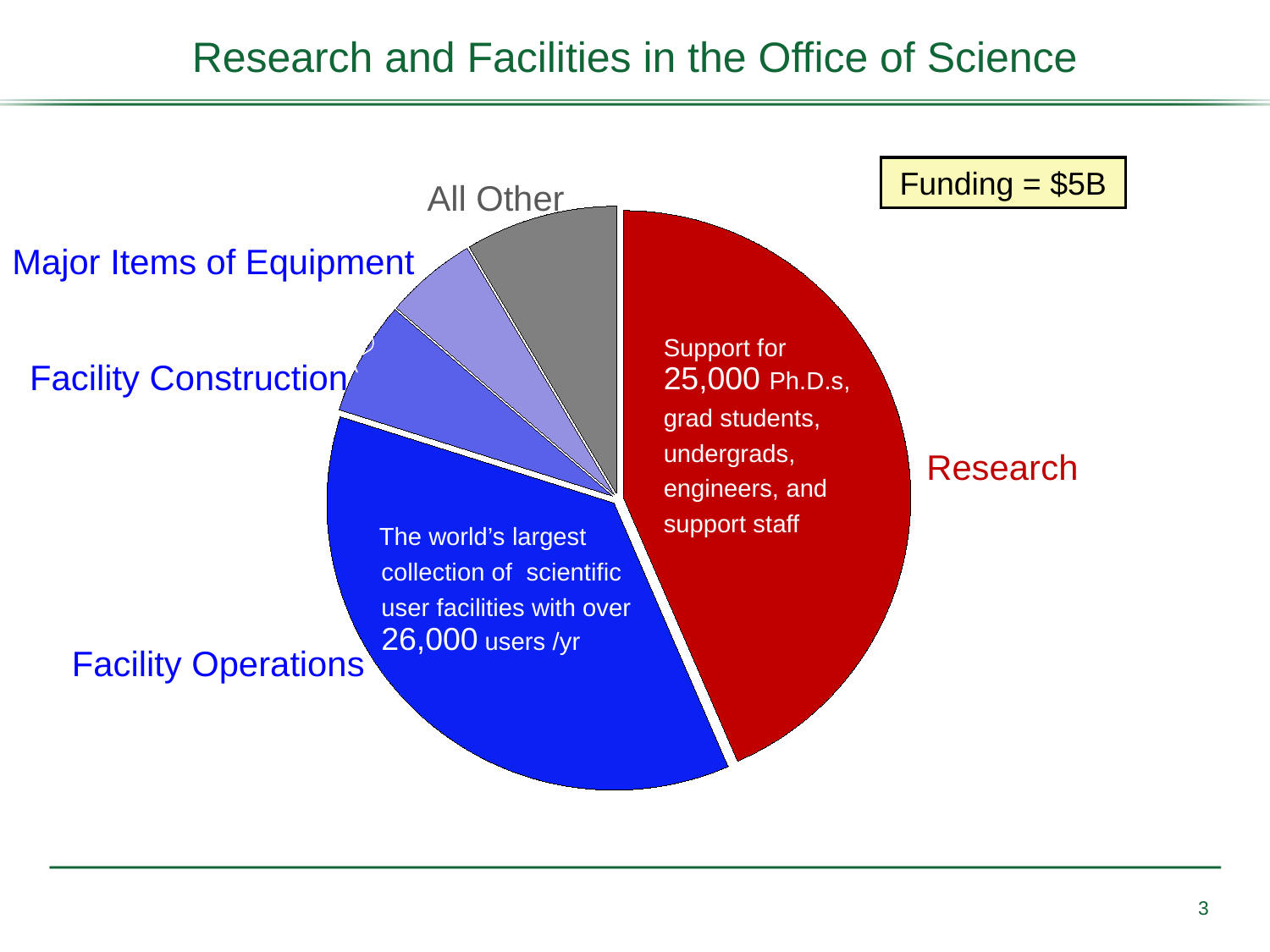
Which slice is larger, Research or Facility Construction? Research What is the title of the slide containing the pie chart? Research and Facilities in the Office of Science What kind of chart is shown on the slide? pie chart Which slice is larger, Facility Operations or Facility Construction? Facility Operations Which slice is larger, Facility Operations or All Other? Facility Operations How many slices does the pie chart have? 5 What total funding amount is stated next to the pie chart? $5B Which category has the largest slice of the pie chart? Research